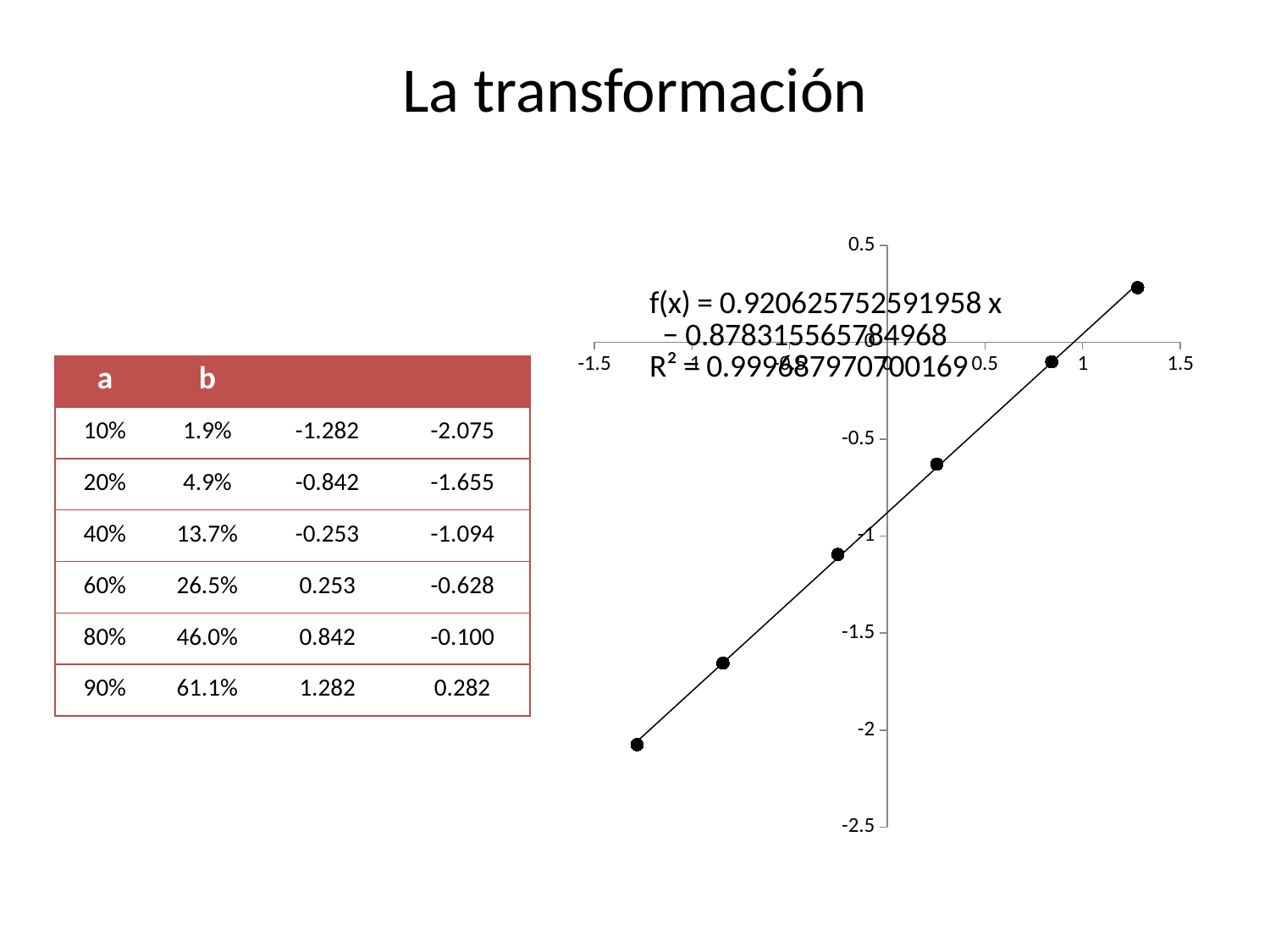
Which point has the highest y value: the leftmost point or the rightmost point? the rightmost point What is the lowest value shown on the y axis of the chart? -2.5 Do the plotted values rise or fall as x increases along the x axis? rise Is the y value of the point near x = 0.85 greater or less than 0? less What is the R² value shown on the chart? 0.999687970700169 What kind of chart is shown on the slide? scatter chart with a trendline Is the y value of the point near x = -0.25 greater or less than -1? less Is the y value of the rightmost point (near x = 1.3) greater or less than 0? greater What is the slope of the fitted line f(x) shown on the chart? 0.920625752591958 How many data points are plotted on the chart? 6